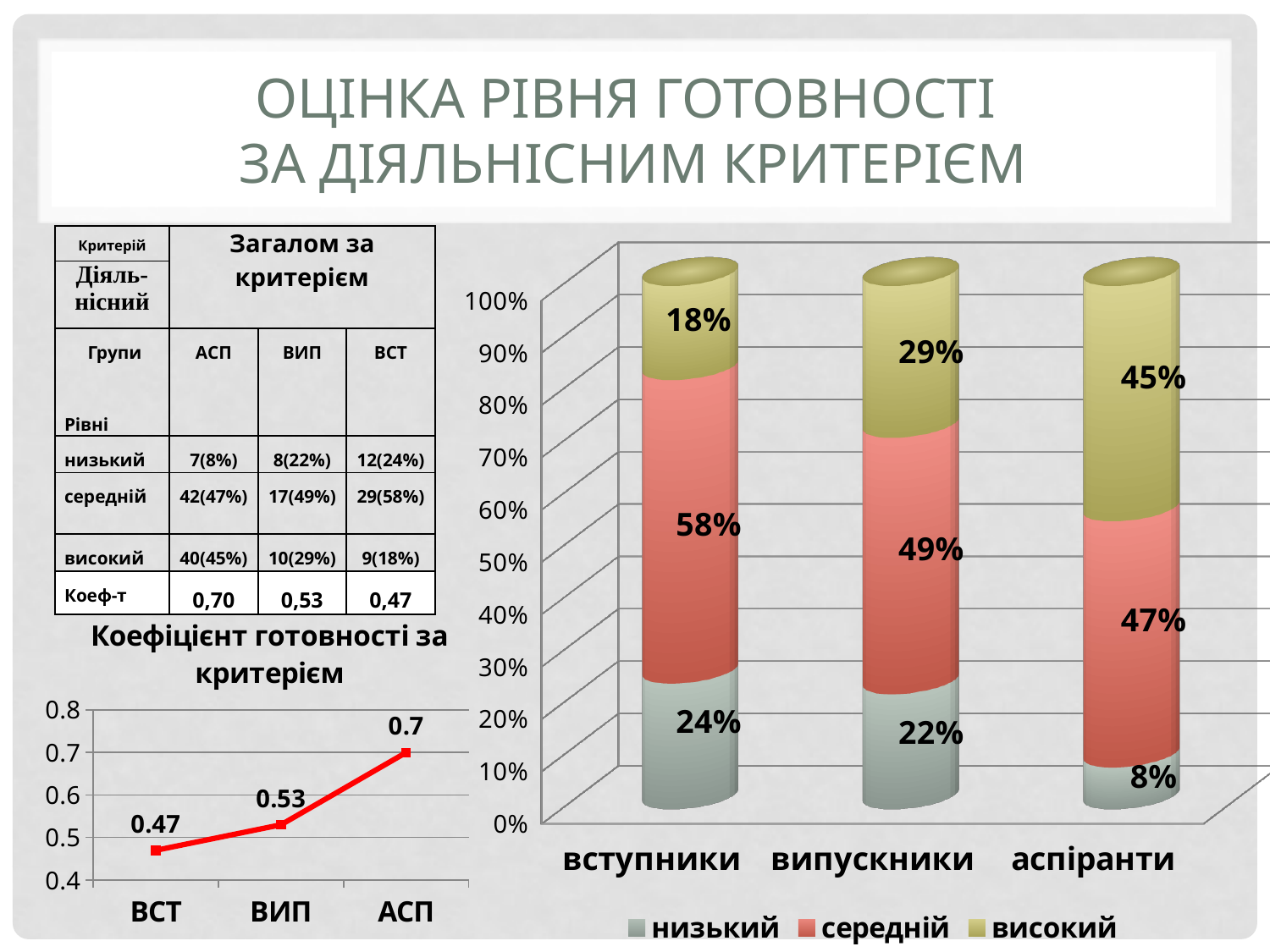
In the stacked bar chart on the right, what is the value of the 'високий' segment for 'аспіранти'? 45% In the chart 'Коефіцієнт готовності за критерієм', what kind of chart is shown? line chart In the chart 'Коефіцієнт готовності за критерієм', what is the value for 'ВИП'? 0.53 In the stacked bar chart on the right, what is the value of the 'низький' segment for 'вступники'? 24% In the stacked bar chart on the right, what is the value of the 'середній' segment for 'випускники'? 49% In the stacked bar chart on the right, which category has the lowest 'низький' value? аспіранти In the stacked bar chart on the right, how many categories are shown on the x axis? 3 In the chart 'Коефіцієнт готовності за критерієм', do the values rise or fall from 'ВСТ' to 'АСП'? rise In the stacked bar chart on the right, how many series does the legend list? 3 In the stacked bar chart on the right, what is the difference between the 'середній' values for 'вступники' and 'аспіранти'? 11% In the chart 'Коефіцієнт готовності за критерієм', what is the difference between the values for 'АСП' and 'ВСТ'? 0.23 In the stacked bar chart on the right, which category has the highest 'високий' value? аспіранти